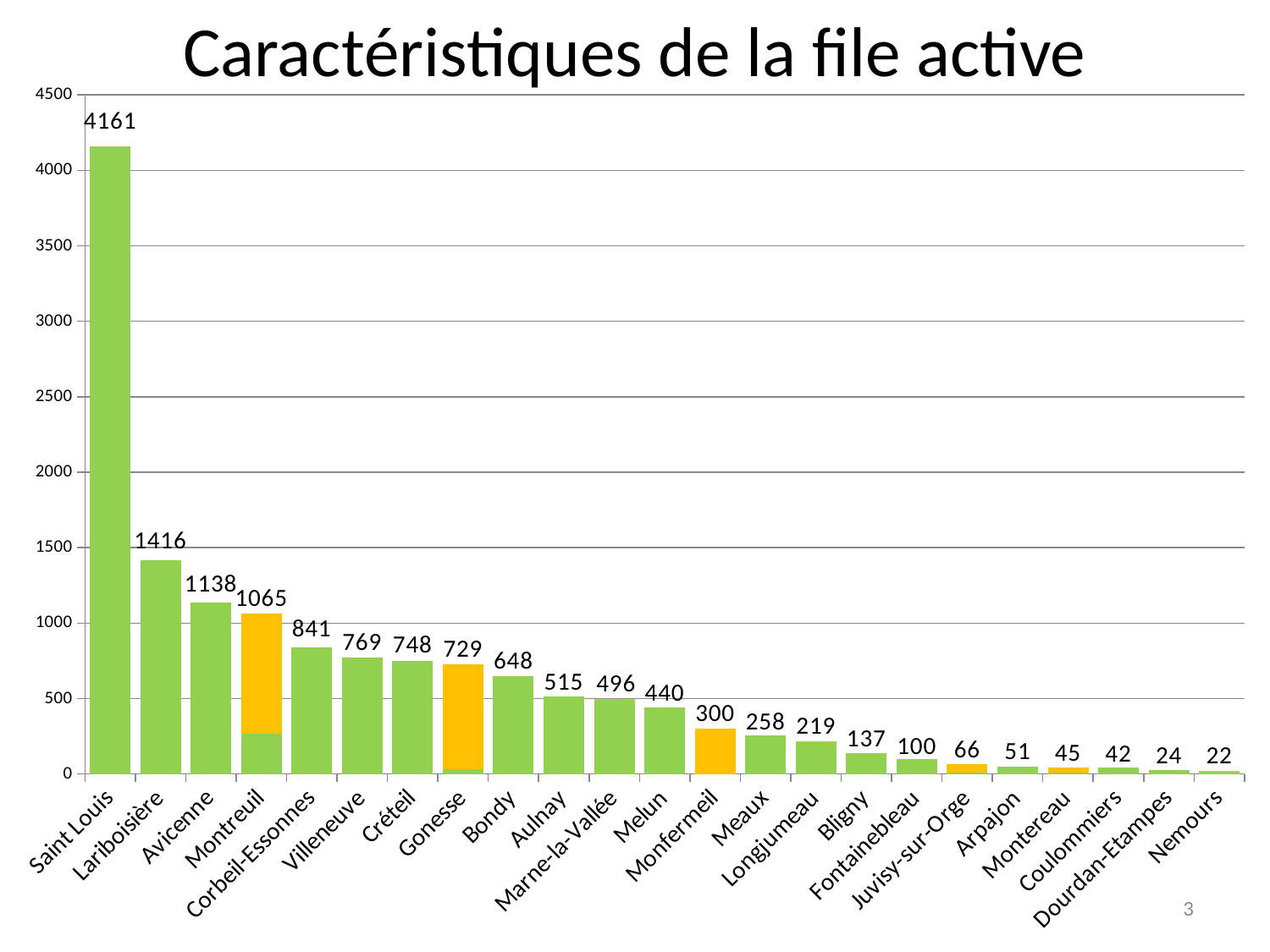
How many categories are shown on the x axis? 23 Which category has the highest value? Saint Louis What is the value shown for Saint Louis? 4161 Which category has the lowest value? Nemours What is the value shown for Gonesse? 729 What is the value shown for Montreuil? 1065 What is the value shown for Monfermeil? 300 What kind of chart is shown on the slide? Bar chart What is the difference between the values for Saint Louis and Lariboisière? 2745 What is the title of the chart? Caractéristiques de la file active Do the values rise or fall from left to right along the x axis? Fall Which is larger, the value for Avicenne or the value for Montreuil? Avicenne